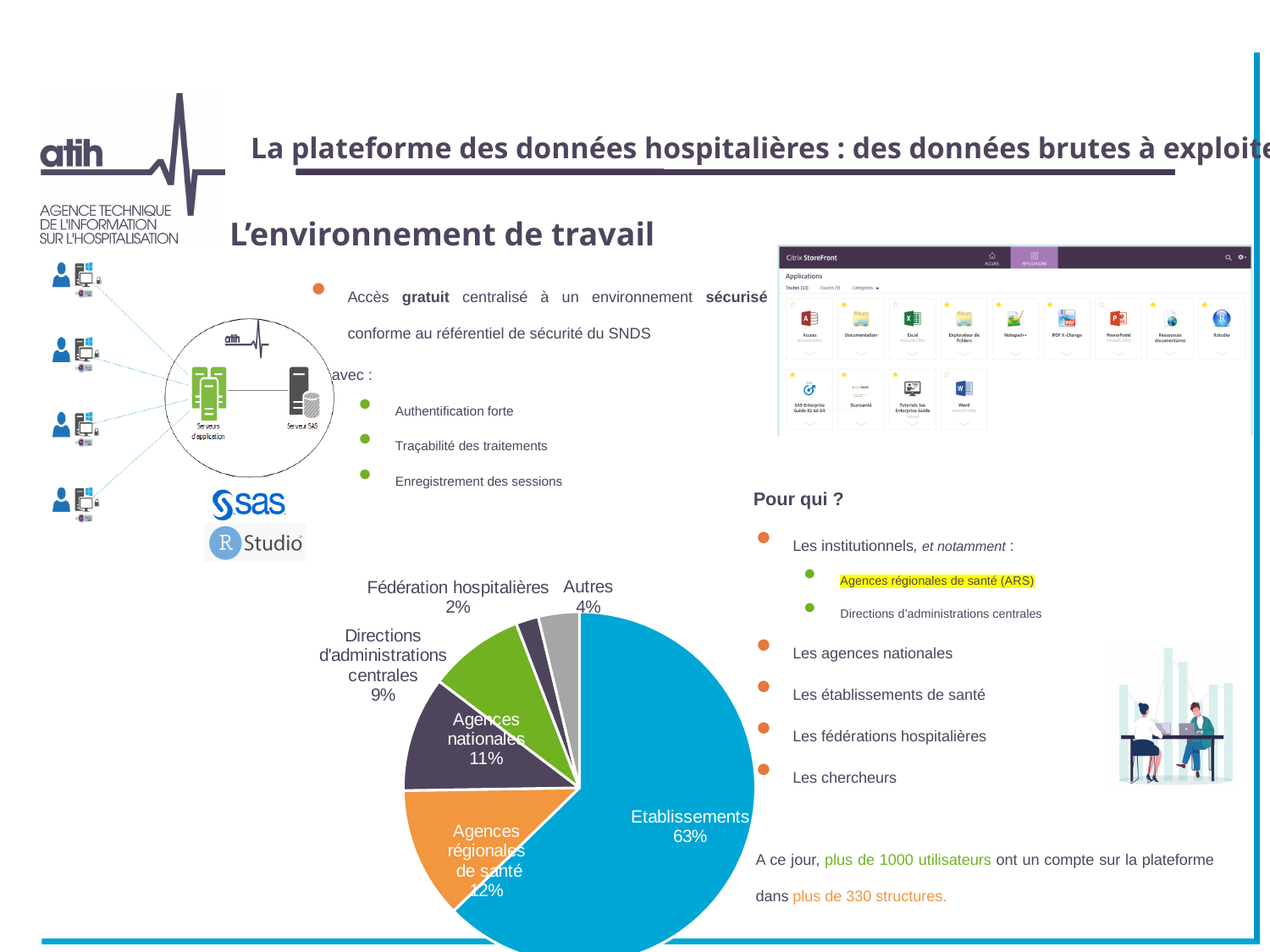
Which category has the smallest slice of the pie chart? Fédération hospitalières Which is larger in the pie chart, Agences nationales or Directions d'administrations centrales? Agences nationales What share of the pie chart is Autres? 4% What share of the pie chart is Directions d'administrations centrales? 9% What is the difference in percentage points between Etablissements and Agences nationales in the pie chart? 52 What share of the pie chart is Fédération hospitalières? 2% Which category has the largest slice of the pie chart? Etablissements What share of the pie chart is Etablissements? 63% What share of the pie chart is Agences nationales? 11% What kind of chart is shown on the slide? pie chart How many slices does the pie chart have? 6 What is the difference in percentage points between Autres and Fédération hospitalières in the pie chart? 2